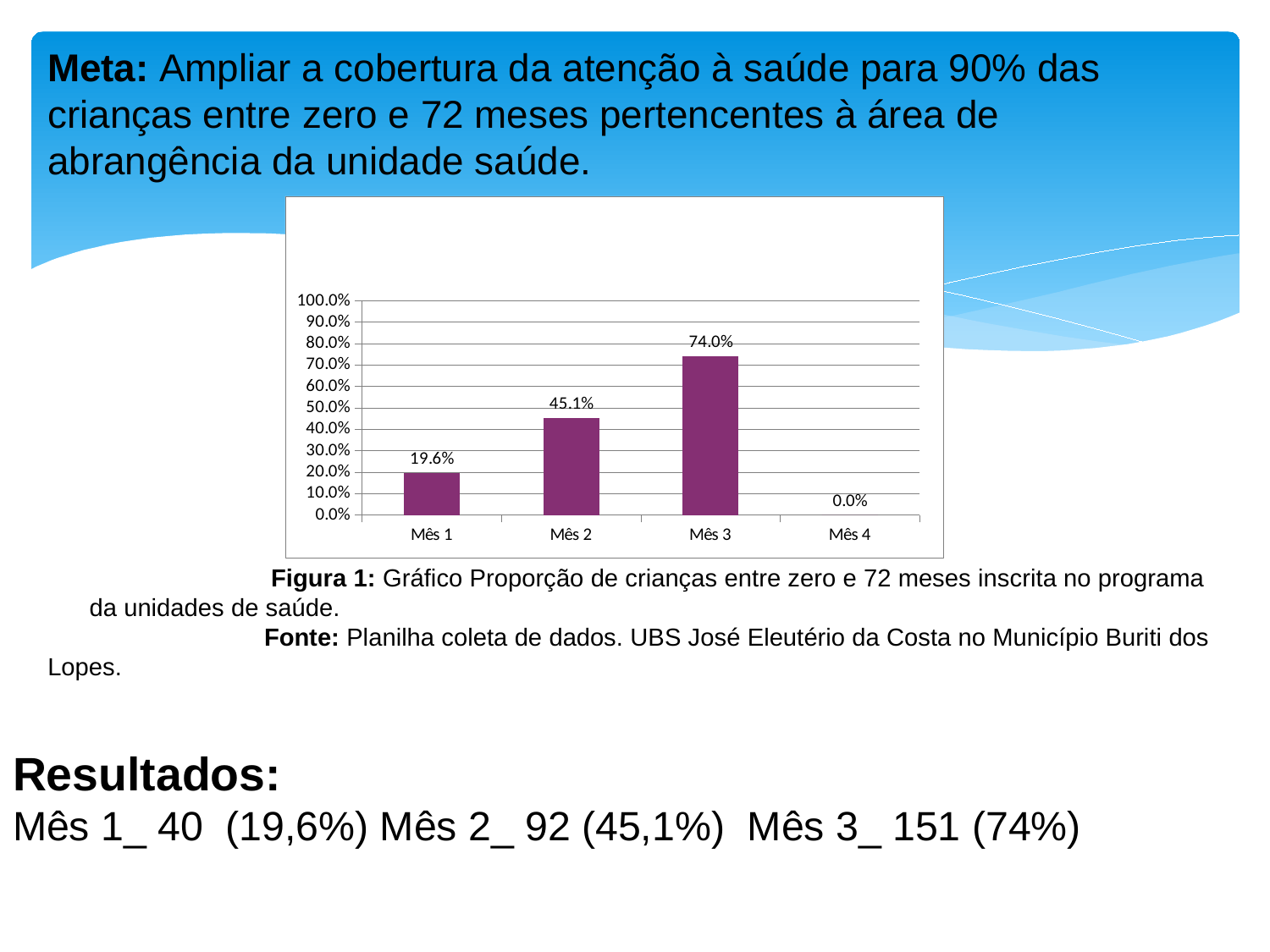
Which is larger, the value for Mês 1 or the value for Mês 2? Mês 2 What is the value for Mês 4? 0.0% Do the values rise or fall from Mês 1 to Mês 3? Rise What is the difference between the values for Mês 3 and Mês 2? 28.9% What is the value for Mês 2? 45.1% What kind of chart is shown? Bar chart How many categories are shown on the x axis? 4 What is the difference between the values for Mês 2 and Mês 1? 25.5% What is the value for Mês 1? 19.6% Which month has the lowest value? Mês 4 Which month has the highest value? Mês 3 What is the value for Mês 3? 74.0%